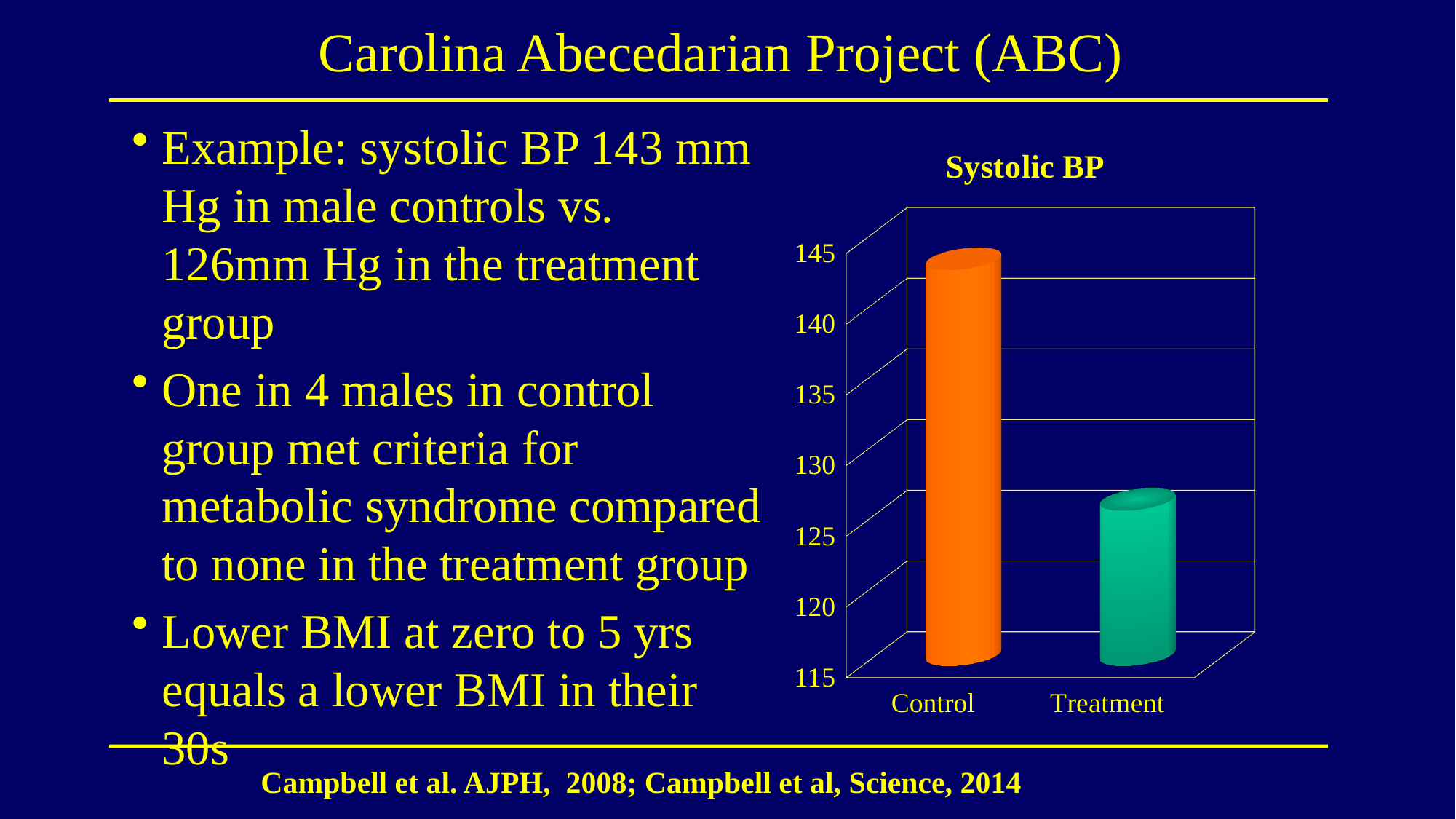
What colour is the Control bar in the Systolic BP chart? orange Which category has the highest bar in the Systolic BP chart? Control Is the value for Treatment greater or less than 130? less Is the value for Control greater or less than 145? less Is the value for Treatment greater or less than 125? greater Which is larger in the Systolic BP chart, the value for Control or the value for Treatment? Control What is the title of the chart? Systolic BP Which category has the lowest bar in the Systolic BP chart? Treatment What is the lowest value shown on the y axis of the chart? 115 How many categories are shown on the x axis of the chart? 2 What type of chart is shown on the slide? bar chart